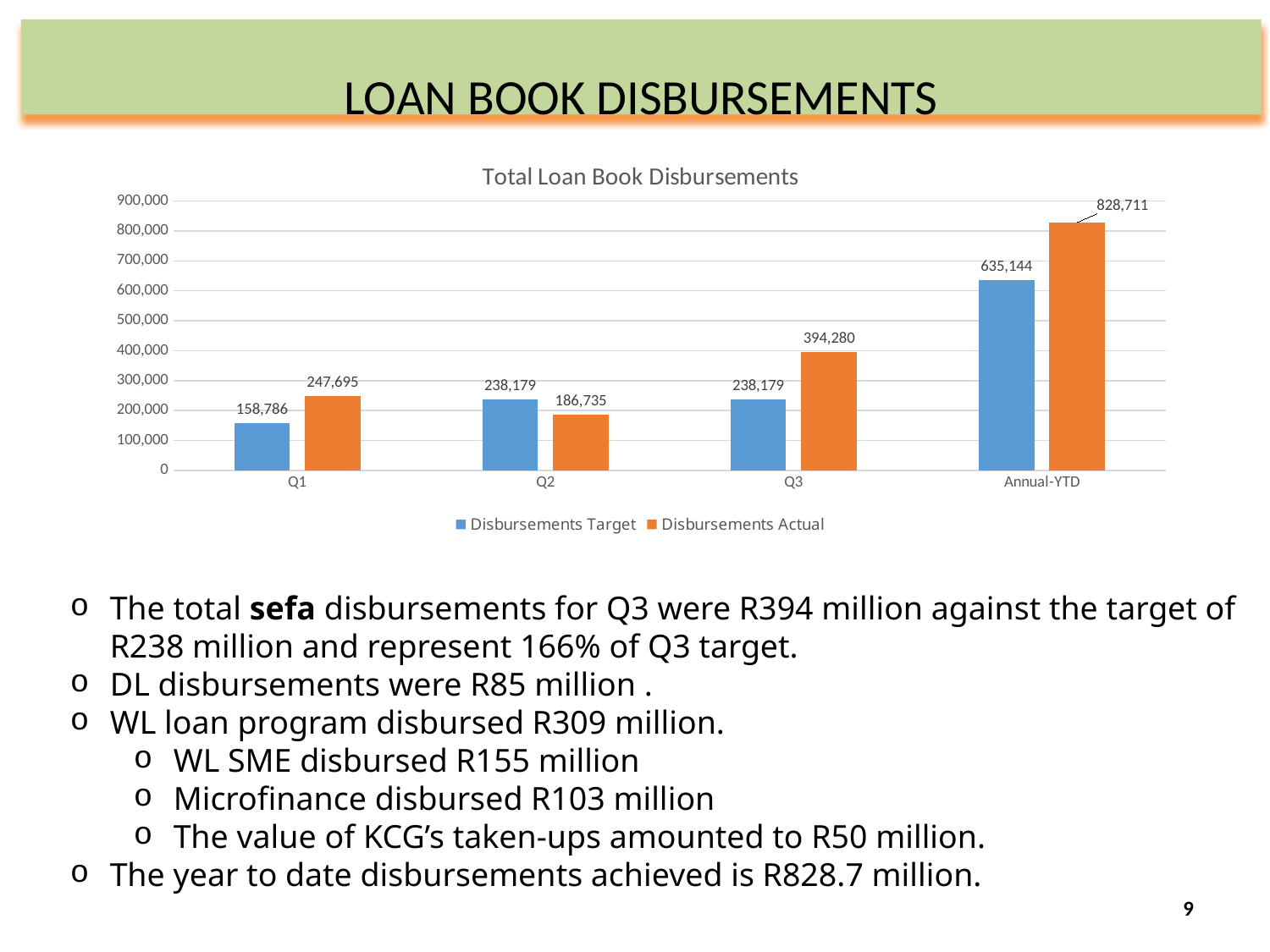
What type of chart is shown on the slide? Bar chart What is the Disbursements Target value for Q1? 158,786 For Q2, which is larger: Disbursements Target or Disbursements Actual? Disbursements Target Which category has the lowest Disbursements Target value? Q1 What is the Disbursements Actual value for Q3? 394,280 Which category has the highest Disbursements Actual value? Annual-YTD How many series does the legend list? 2 What is the difference between Disbursements Actual and Disbursements Target for Q3? 156,101 What is the difference between Disbursements Actual and Disbursements Target for Annual-YTD? 193,567 What is the Disbursements Actual value for Q2? 186,735 How many categories are shown on the x axis? 4 What is the Disbursements Target value for Annual-YTD? 635,144